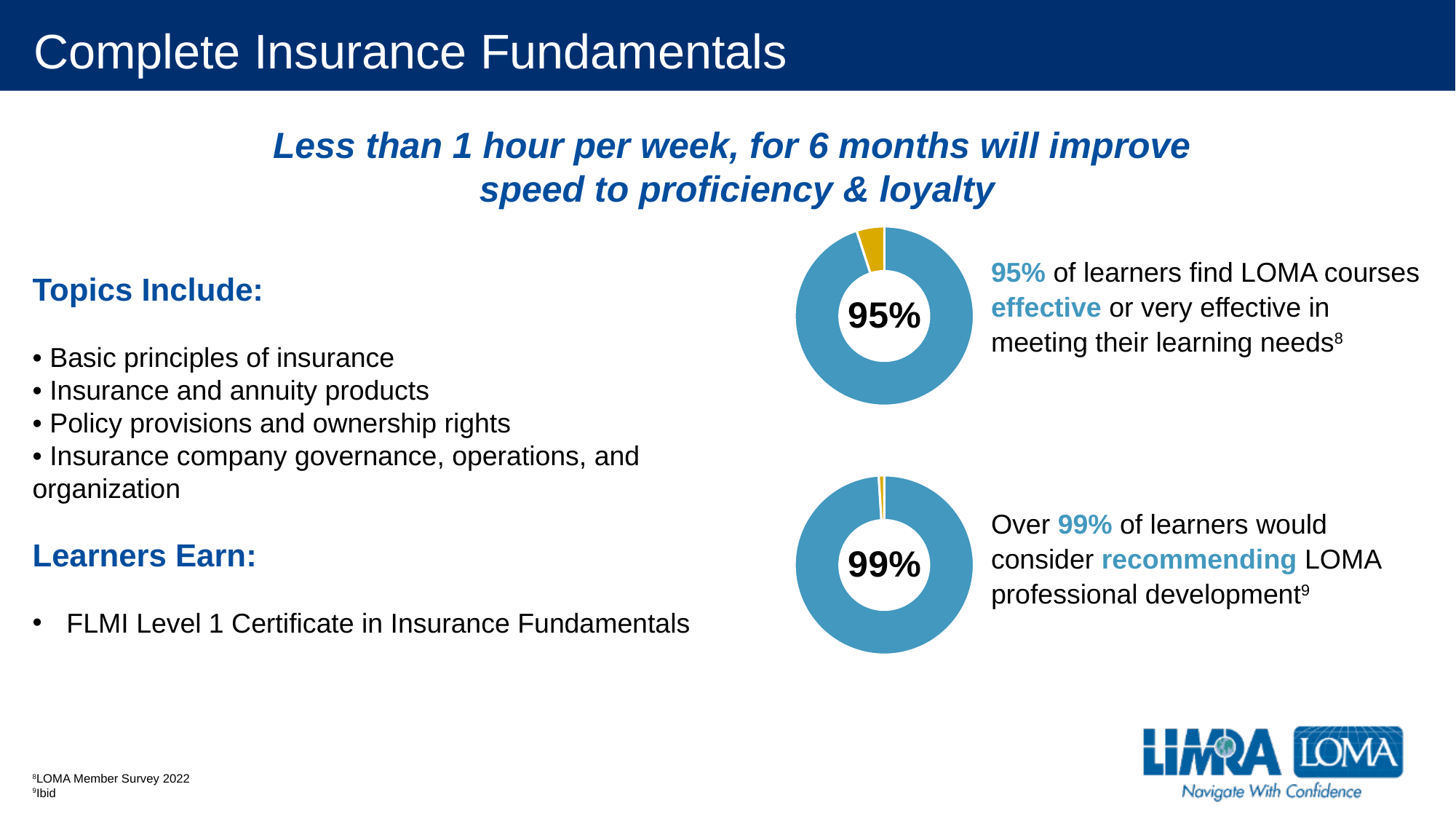
How many slices does the upper donut chart have? 2 In the upper donut chart, what share of the whole does the small yellow slice represent? 5% What value is printed in the centre of the upper donut chart? 95% What does the 99% in the lower donut chart represent, according to the text beside it? Learners who would consider recommending LOMA professional development Which donut chart shows the larger percentage, the upper one or the lower one? The lower one (99%) In the lower donut chart, what share of the whole does the small yellow slice represent? 1% What colour is the large slice in both donut charts? Blue How many slices does the lower donut chart have? 2 Is the value shown in the upper donut chart greater or less than 90%? greater What is the difference between the percentage in the lower donut chart and the percentage in the upper donut chart? 4% What value is printed in the centre of the lower donut chart? 99% What kind of chart is shown next to the text about learners finding LOMA courses effective? Donut (pie) chart